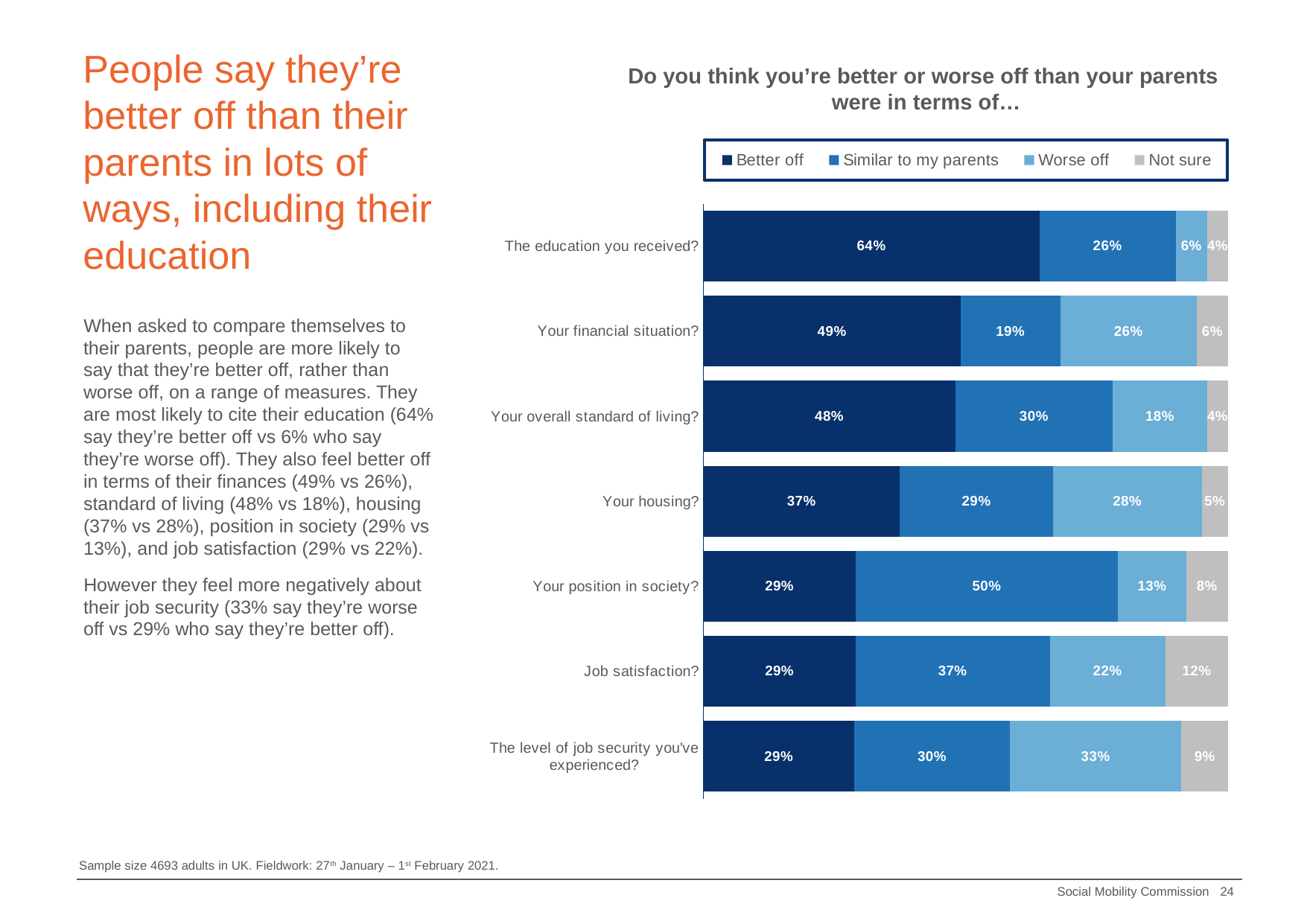
What kind of chart is shown on the slide? Stacked bar chart Which category has the highest 'Better off' percentage? The education you received? For your housing, which is larger: the 'Better off' share or the 'Worse off' share? Better off How many series does the legend list? 4 What is the difference between the 'Better off' and 'Worse off' percentages for your financial situation? 23% What percentage say they are better off than their parents in terms of the education they received? 64% What percentage say their position in society is similar to their parents? 50% How many categories are shown in the chart? 7 What is the title of the chart? Do you think you're better or worse off than your parents were in terms of… What percentage say they are worse off than their parents in terms of the level of job security they've experienced? 33% Which category has the lowest 'Worse off' percentage? The education you received? What percentage are not sure about job satisfaction compared with their parents? 12%